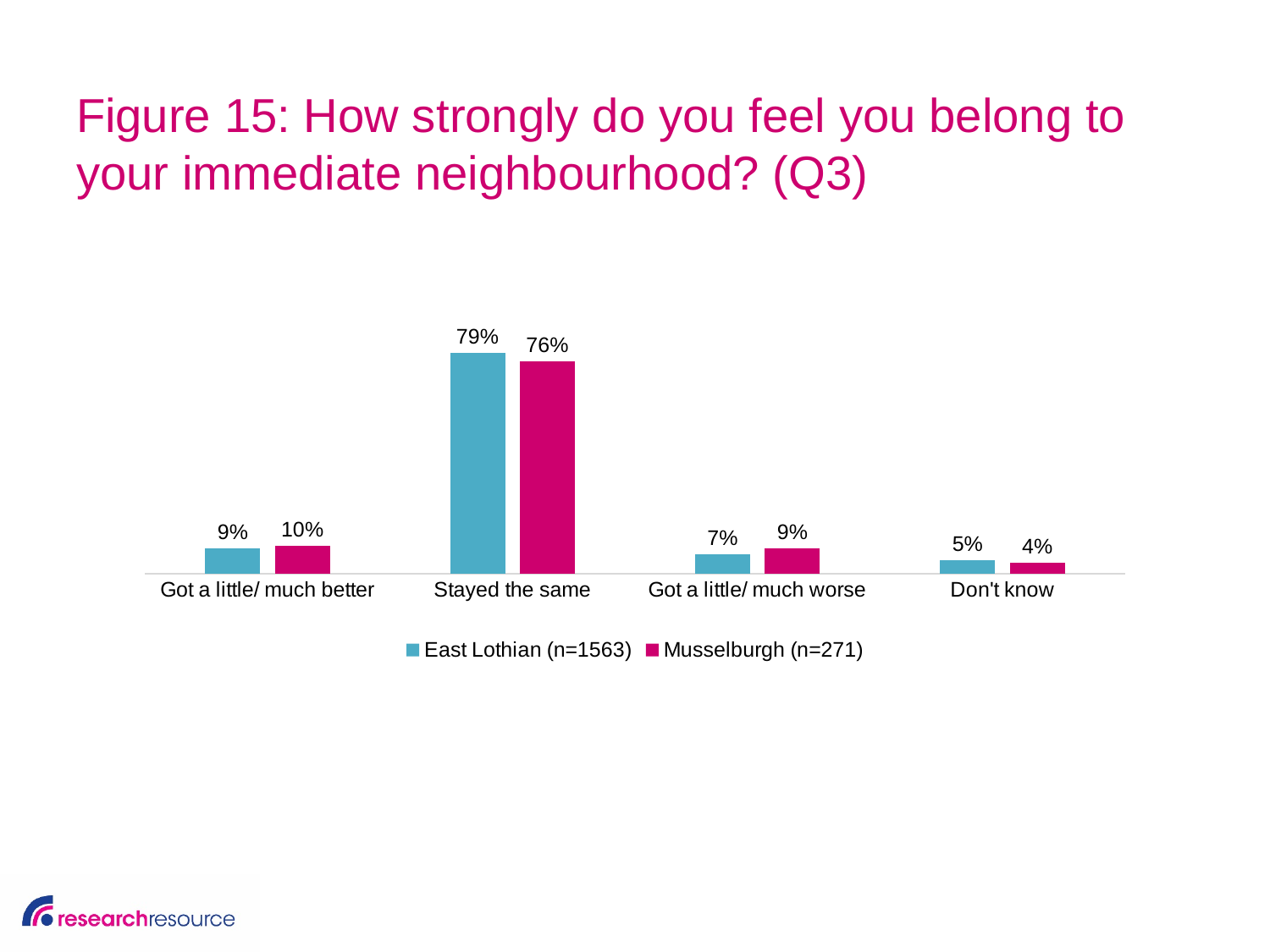
What is the value for Musselburgh (n=271) for 'Got a little/ much worse'? 9% Which category has the highest value for Musselburgh (n=271)? Stayed the same What is the difference between East Lothian (n=1563) and Musselburgh (n=271) for 'Stayed the same'? 3% What kind of chart is shown on the slide? Bar chart What is the value for Musselburgh (n=271) for 'Don't know'? 4% How many categories are shown on the x axis? 4 How many series does the legend list? 2 What is the value for East Lothian (n=1563) for 'Stayed the same'? 79% Which category has the lowest value for East Lothian (n=1563)? Don't know For 'Got a little/ much worse', which series has the larger value, East Lothian (n=1563) or Musselburgh (n=271)? Musselburgh (n=271) What is the value for East Lothian (n=1563) for 'Got a little/ much better'? 9% Which colour represents Musselburgh (n=271) in the chart? Pink/magenta